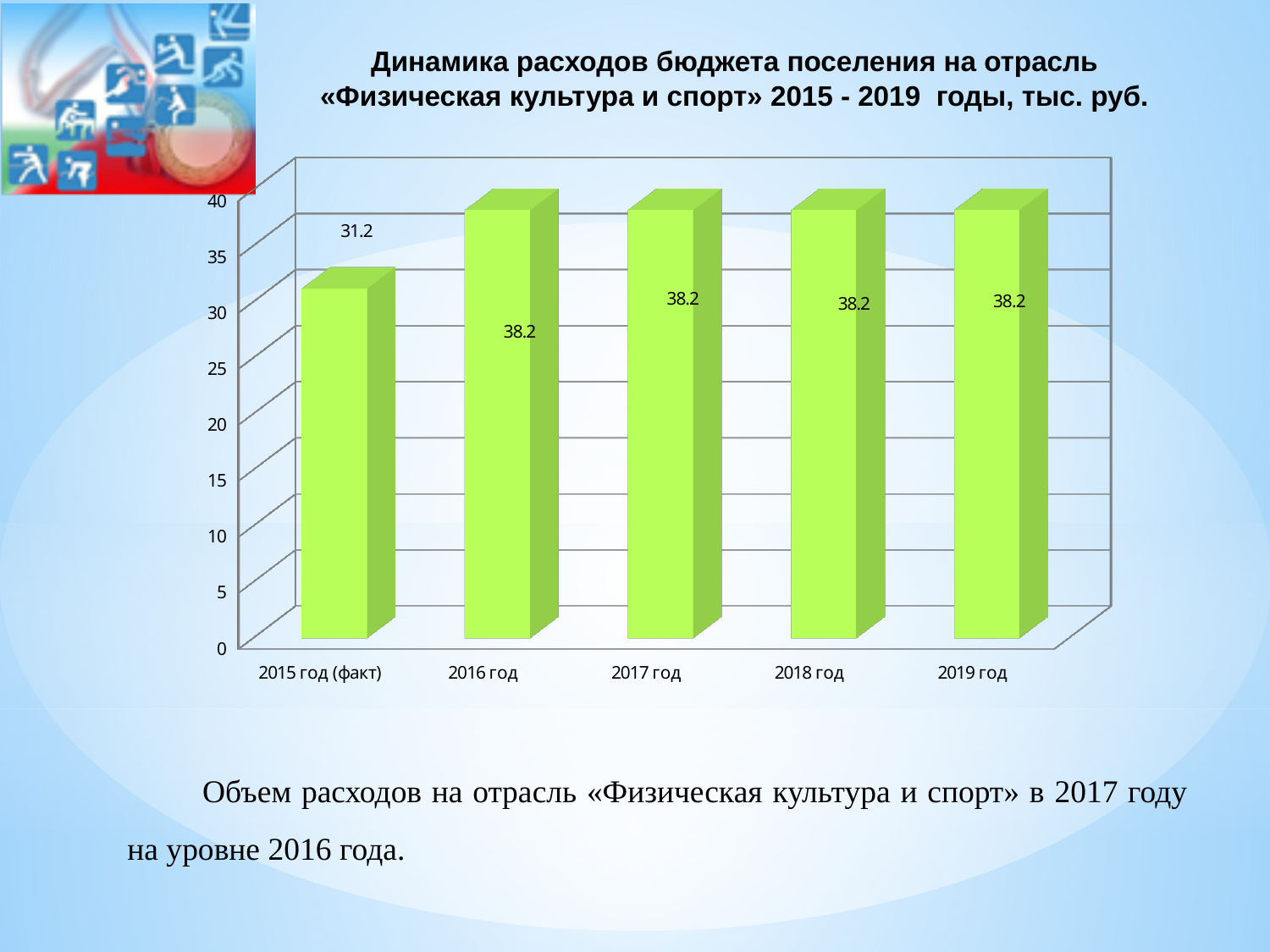
Is the value for 2017 год greater or less than 35? greater What kind of chart is shown on the slide? bar chart What is the value for 2015 год (факт)? 31.2 Is the value for 2015 год (факт) greater or less than 35? less What is the difference between the values for 2016 год and 2015 год (факт)? 7 What is the value for 2019 год? 38.2 Do the values rise or fall from 2015 год (факт) to 2016 год? rise Which category has the lowest value? 2015 год (факт) How many categories are shown on the x axis? 5 Which is larger, the value for 2015 год (факт) or the value for 2018 год? 2018 год What is the value for 2017 год? 38.2 What colour are the bars in the chart? green